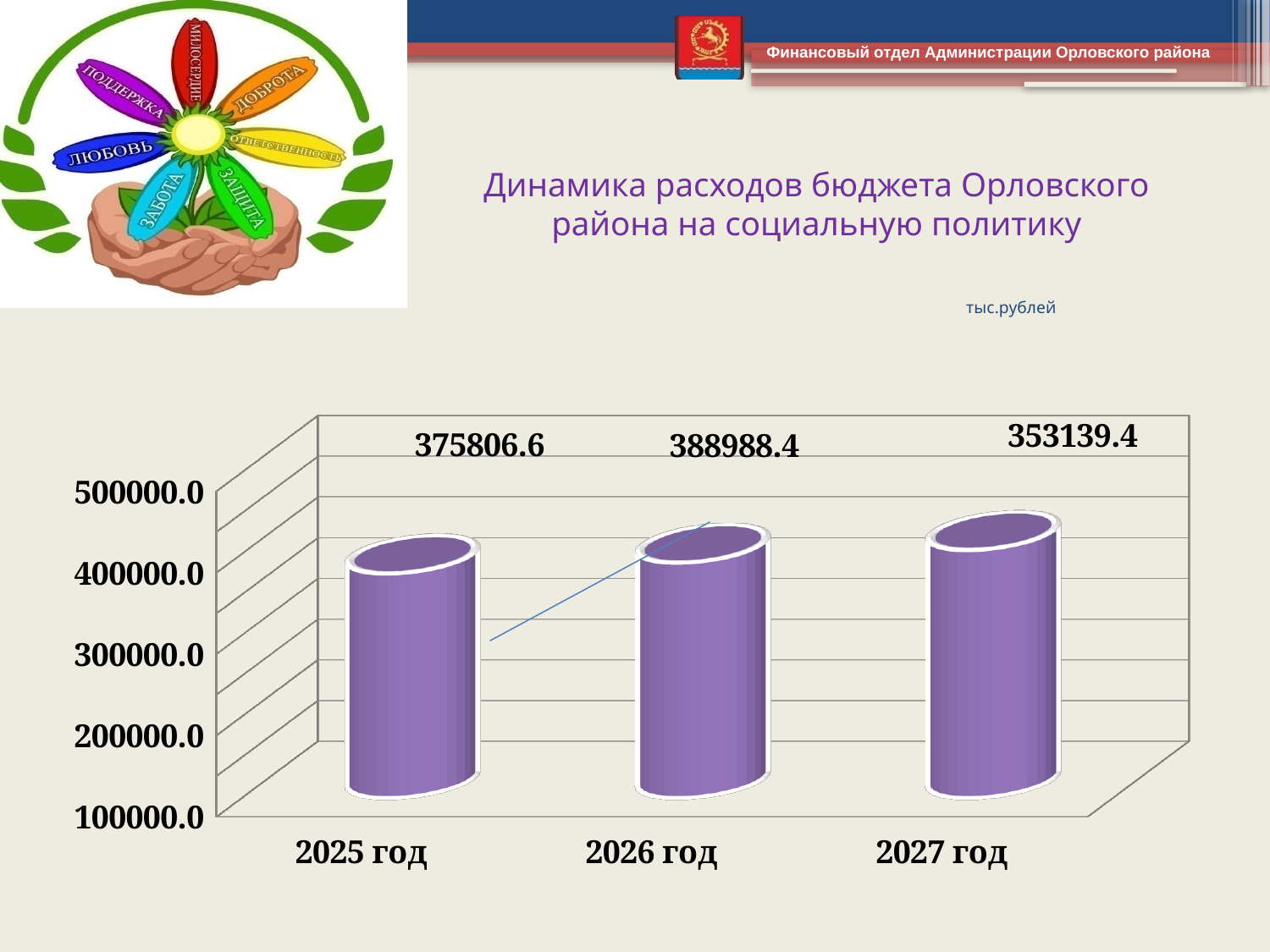
How many years are shown on the chart? 3 What is the value for 2026 год? 388988.4 What is the difference between the values for 2026 год and 2027 год? 35849.0 What is the value for 2025 год? 375806.6 What unit of measurement is indicated for the chart? тыс.рублей What is the value for 2027 год? 353139.4 What kind of chart is shown on the slide? bar chart What is the difference between the values for 2026 год and 2025 год? 13181.8